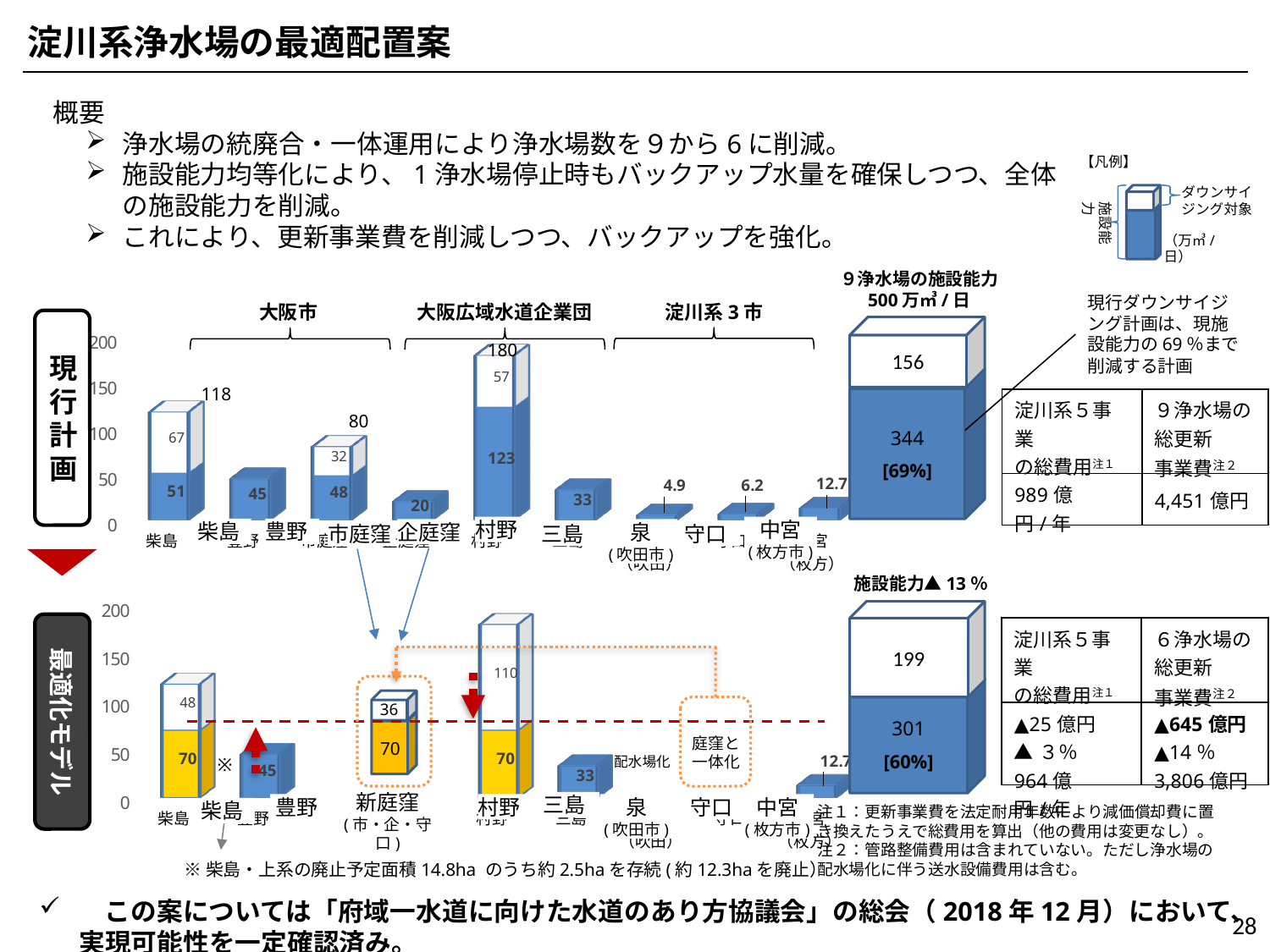
In the 最適化モデル (bottom) chart, what is the white (downsizing) portion of the 村野 bar? 110 In the 最適化モデル (bottom) chart, which is larger, the value for 豊野 or 三島? 豊野 In the 現行計画 (top) chart, is the value for 豊野 greater or less than 50? less In the 現行計画 (top) chart, which plant has the lowest value? 泉 In the 現行計画 (top) chart, what is the total value shown for 村野? 180 In the 現行計画 (top) chart, what is the value for 企庭窪? 20 In the 現行計画 (top) chart, what is the total value shown for 柴島? 118 What kind of chart is used for the 現行計画 (top) chart? bar chart In the 現行計画 (top) chart, what is the blue (施設能力) portion of the 村野 bar? 123 In the 最適化モデル (bottom) chart, what is the yellow portion of the 新庭窪 bar? 70 In the 現行計画 (top) chart, what is the difference between the totals for 村野 and 柴島? 62 In the 現行計画 (top) chart, which plant has the highest total capacity? 村野